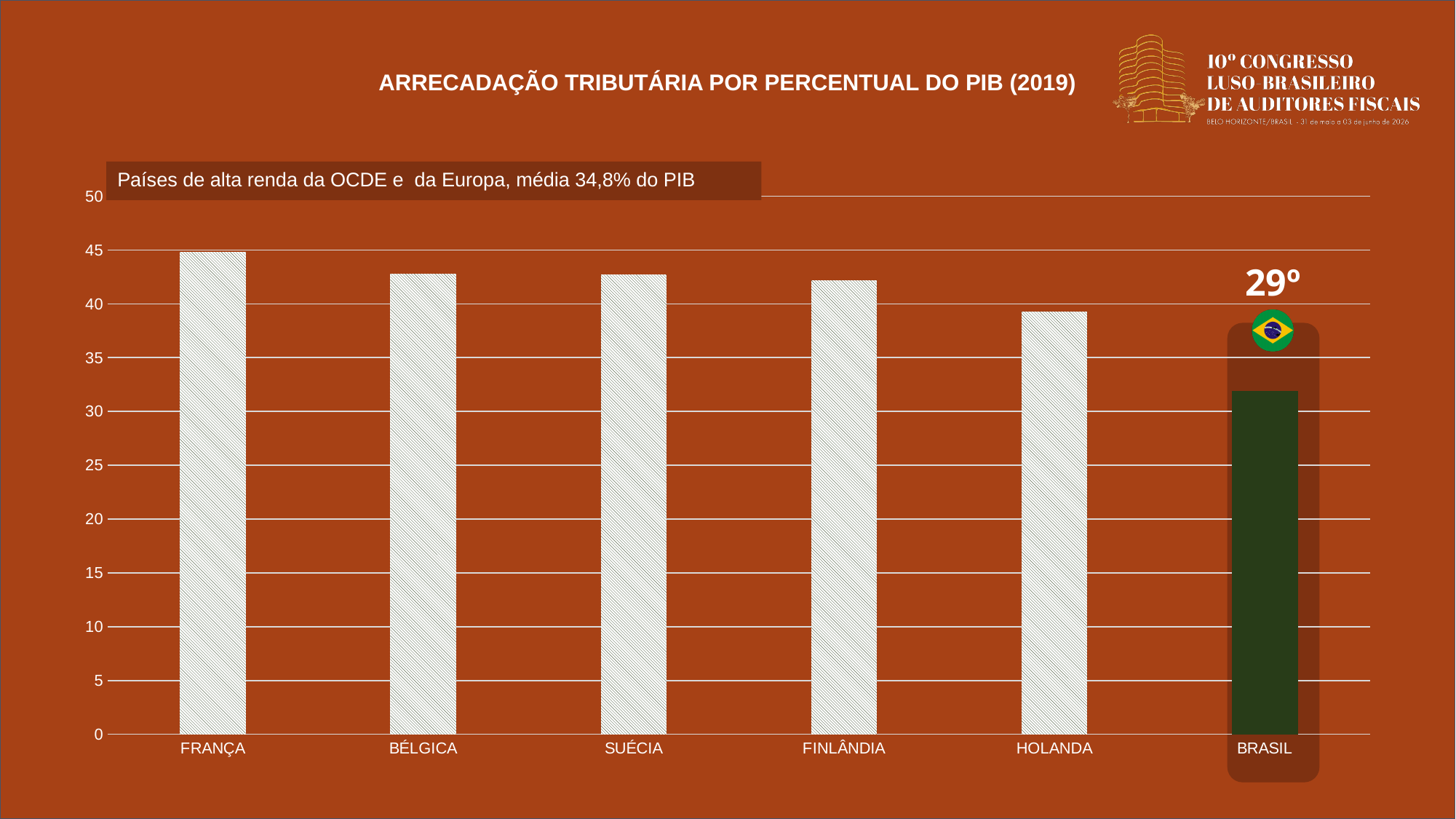
How many countries are shown on the chart? 6 Is the value for FINLÂNDIA greater or less than 40? greater What kind of chart is shown on the slide? bar chart Which has the larger value, HOLANDA or BRASIL? HOLANDA Which has the larger value, FRANÇA or HOLANDA? FRANÇA Do the bar values generally rise or fall from left to right across the chart? fall Which country has the highest bar on the chart? FRANÇA What is the title of the chart? ARRECADAÇÃO TRIBUTÁRIA POR PERCENTUAL DO PIB (2019) Is the value for HOLANDA greater or less than 35? greater Is the value for BRASIL greater or less than 35? less Which country has the lowest bar on the chart? BRASIL